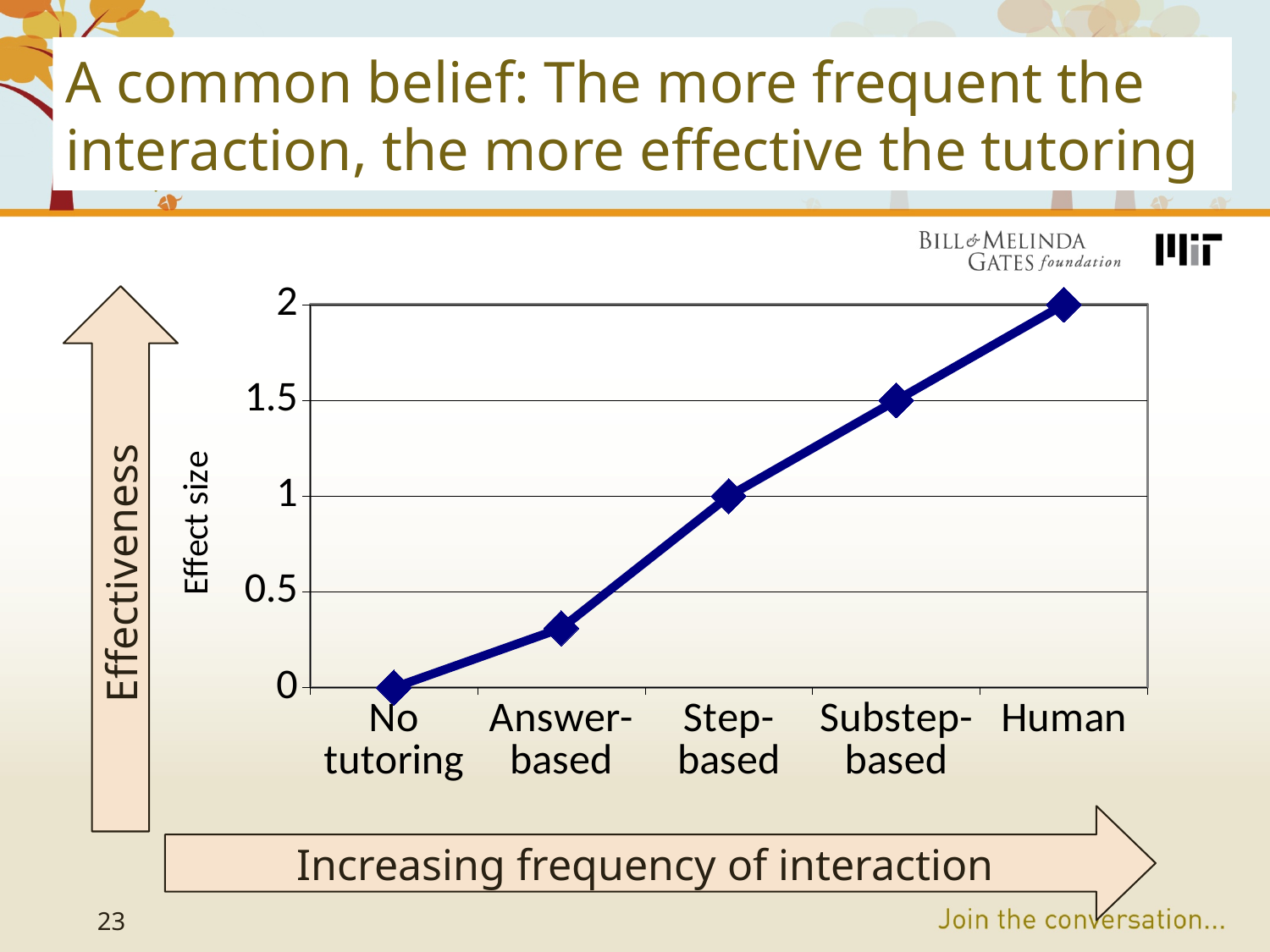
Which category has the highest effect size? Human What is the effect size for Step-based tutoring? 1 What is the effect size for Substep-based tutoring? 1.5 What is the effect size for No tutoring? 0 Do the effect size values rise or fall from No tutoring to Human along the x axis? rise What is the difference in effect size between Human and Step-based tutoring? 1 Which category has the lowest effect size? No tutoring What kind of chart is shown on the slide? line chart Is the effect size for Answer-based tutoring greater or less than 0.5? less What is the label on the y axis of the chart? Effect size How many categories are plotted along the x axis? 5 What is the effect size for Human tutoring? 2